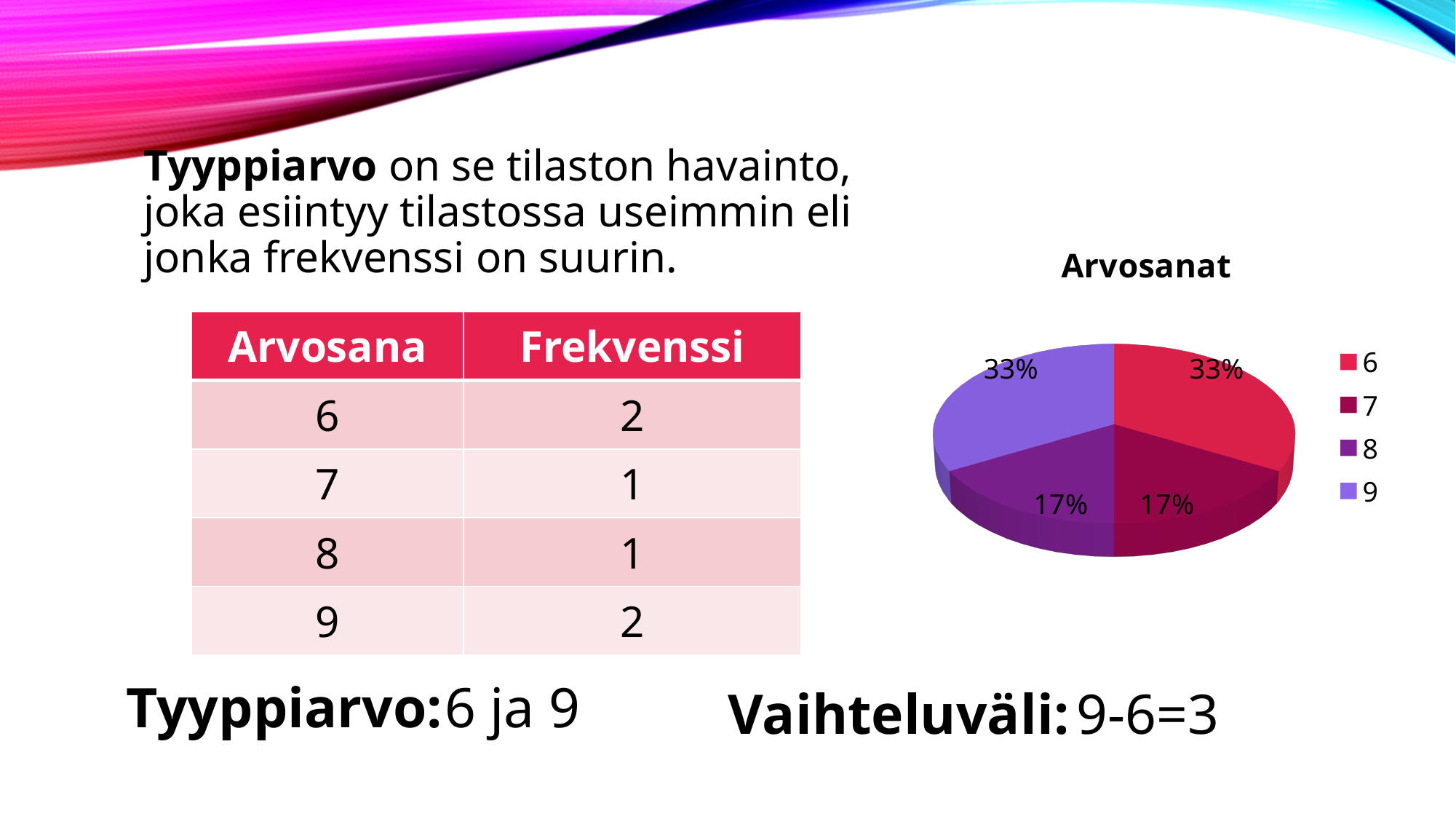
Which categories are listed in the legend of the pie chart? 6, 7, 8, 9 What kind of chart is shown on the slide? pie chart What share of the pie does category 7 have? 17% Which is larger in the pie chart, the slice for 6 or the slice for 7? 6 What is the difference between the share for 9 and the share for 8 in the pie chart? 16% What share of the pie does category 9 have? 33% What is the title of the pie chart? Arvosanat What share of the pie does category 8 have? 17% How many slices does the pie chart have? 4 Is the share for category 7 greater or less than 25%? less Which is larger in the pie chart, the slice for 8 or the slice for 9? 9